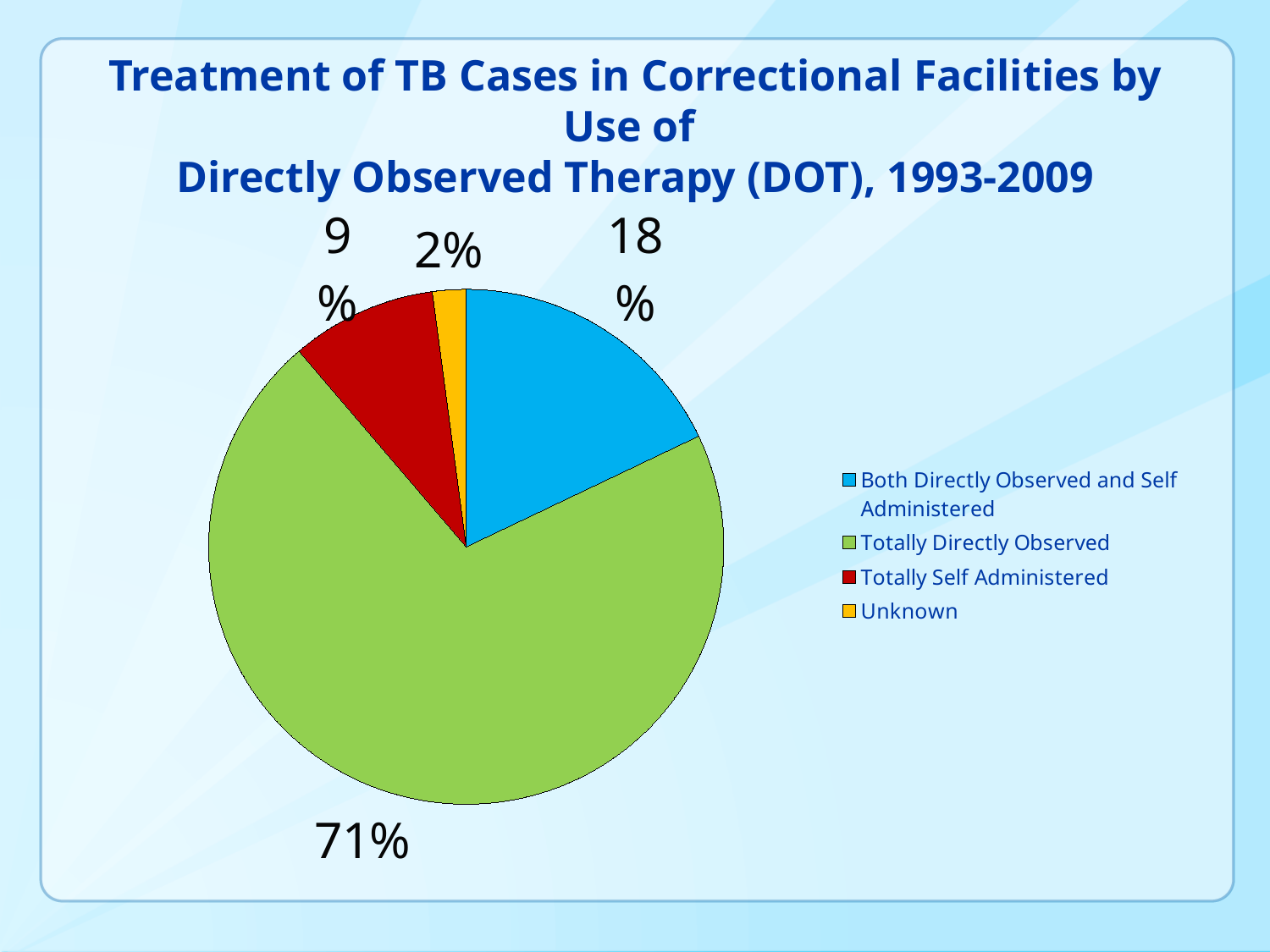
What is the difference in percentage points between Totally Directly Observed and Both Directly Observed and Self Administered? 53 What share of the pie is Unknown? 2% What kind of chart is shown on the slide? pie chart What colour is the slice for Totally Self Administered? red What share of the pie is Totally Self Administered? 9% Which category has the largest slice of the pie? Totally Directly Observed Which is larger, the share for Totally Self Administered or the share for Unknown? Totally Self Administered What share of the pie is Totally Directly Observed? 71% How many categories does the pie chart show? 4 What is the title of the chart? Treatment of TB Cases in Correctional Facilities by Use of Directly Observed Therapy (DOT), 1993-2009 Which category has the smallest slice of the pie? Unknown